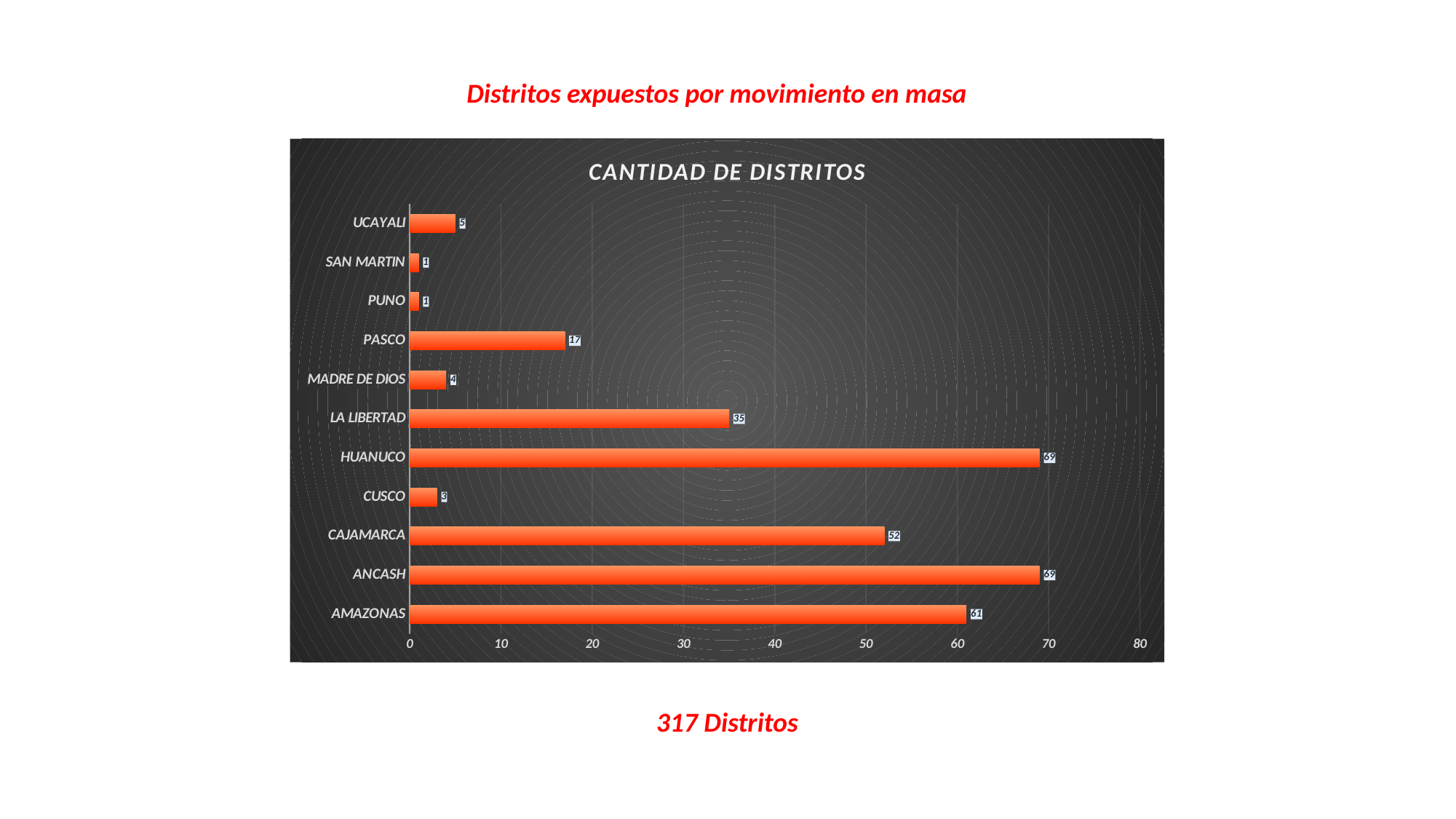
What is the value for PASCO in the CANTIDAD DE DISTRITOS chart? 17 What is the value for CAJAMARCA in the CANTIDAD DE DISTRITOS chart? 52 How many categories are shown in the CANTIDAD DE DISTRITOS chart? 11 What is the value for LA LIBERTAD in the CANTIDAD DE DISTRITOS chart? 35 What is the highest value shown in the CANTIDAD DE DISTRITOS chart? 69 What is the difference between the values for AMAZONAS and CAJAMARCA? 9 What kind of chart is shown on the slide? Bar chart Which two categories share the highest value in the CANTIDAD DE DISTRITOS chart? HUANUCO and ANCASH Is the value for AMAZONAS greater or less than 60? greater What is the value for MADRE DE DIOS in the CANTIDAD DE DISTRITOS chart? 4 What is the title of the chart on the slide? CANTIDAD DE DISTRITOS Which has a larger value, LA LIBERTAD or PASCO? LA LIBERTAD